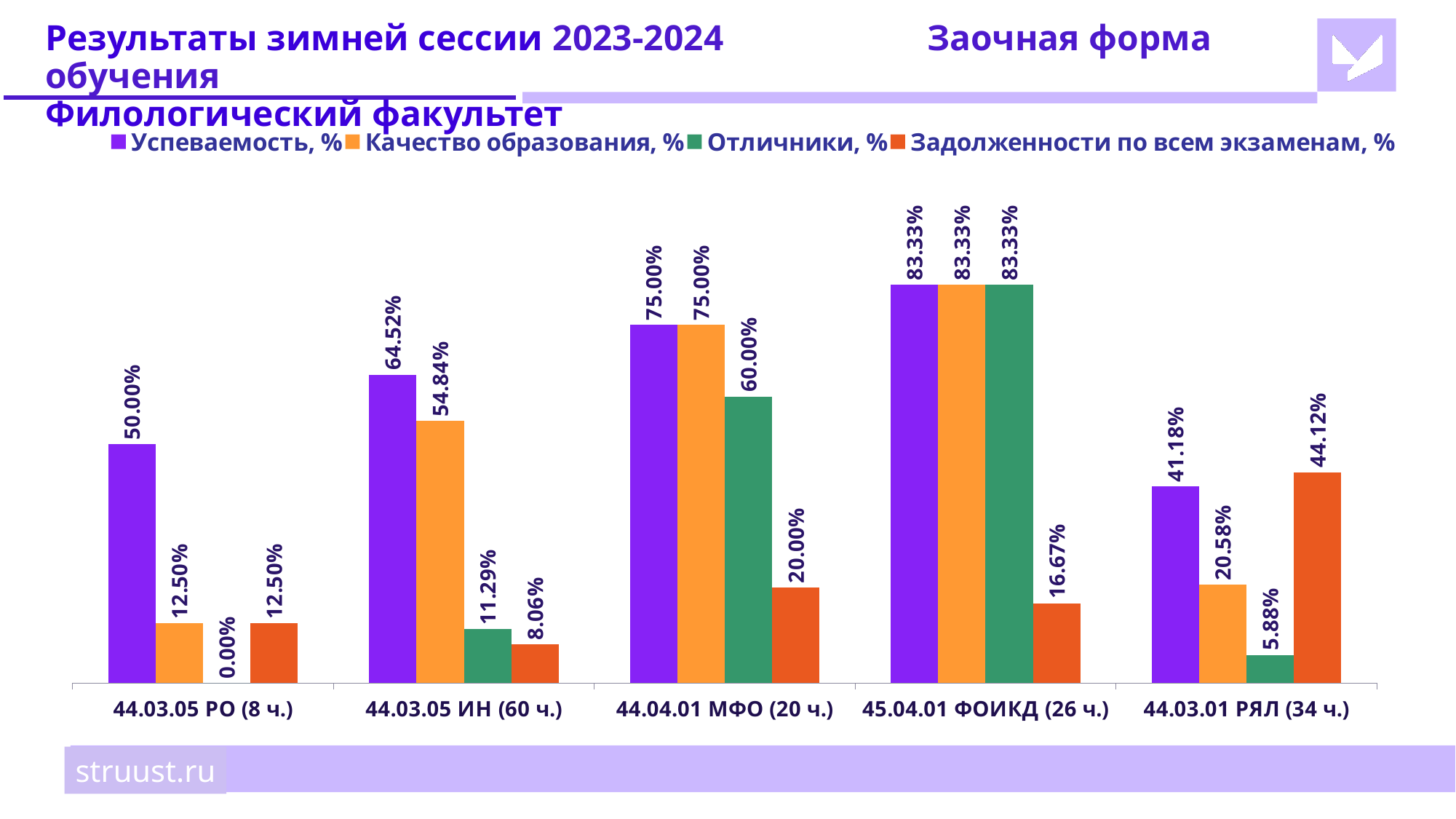
Which category has the highest Успеваемость, % value? 45.04.01 ФОИКД (26 ч.) Which colour represents the Отличники, % series in the legend? Green What kind of chart is shown on the slide? Bar chart What is the Отличники, % value for 44.04.01 МФО (20 ч.)? 60.00% What is the Качество образования, % value for 44.03.05 РО (8 ч.)? 12.50% Which category has the lowest Отличники, % value? 44.03.05 РО (8 ч.) What is the Задолженности по всем экзаменам, % value for 44.03.01 РЯЛ (34 ч.)? 44.12% How many categories are shown on the x axis? 5 What is the difference between the Успеваемость, % values for 44.04.01 МФО (20 ч.) and 44.03.01 РЯЛ (34 ч.)? 33.82% What is the Успеваемость, % value for 44.03.05 ИН (60 ч.)? 64.52% Which is larger for 44.03.01 РЯЛ (34 ч.): Успеваемость, % or Задолженности по всем экзаменам, %? Задолженности по всем экзаменам, % How many series does the legend list? 4